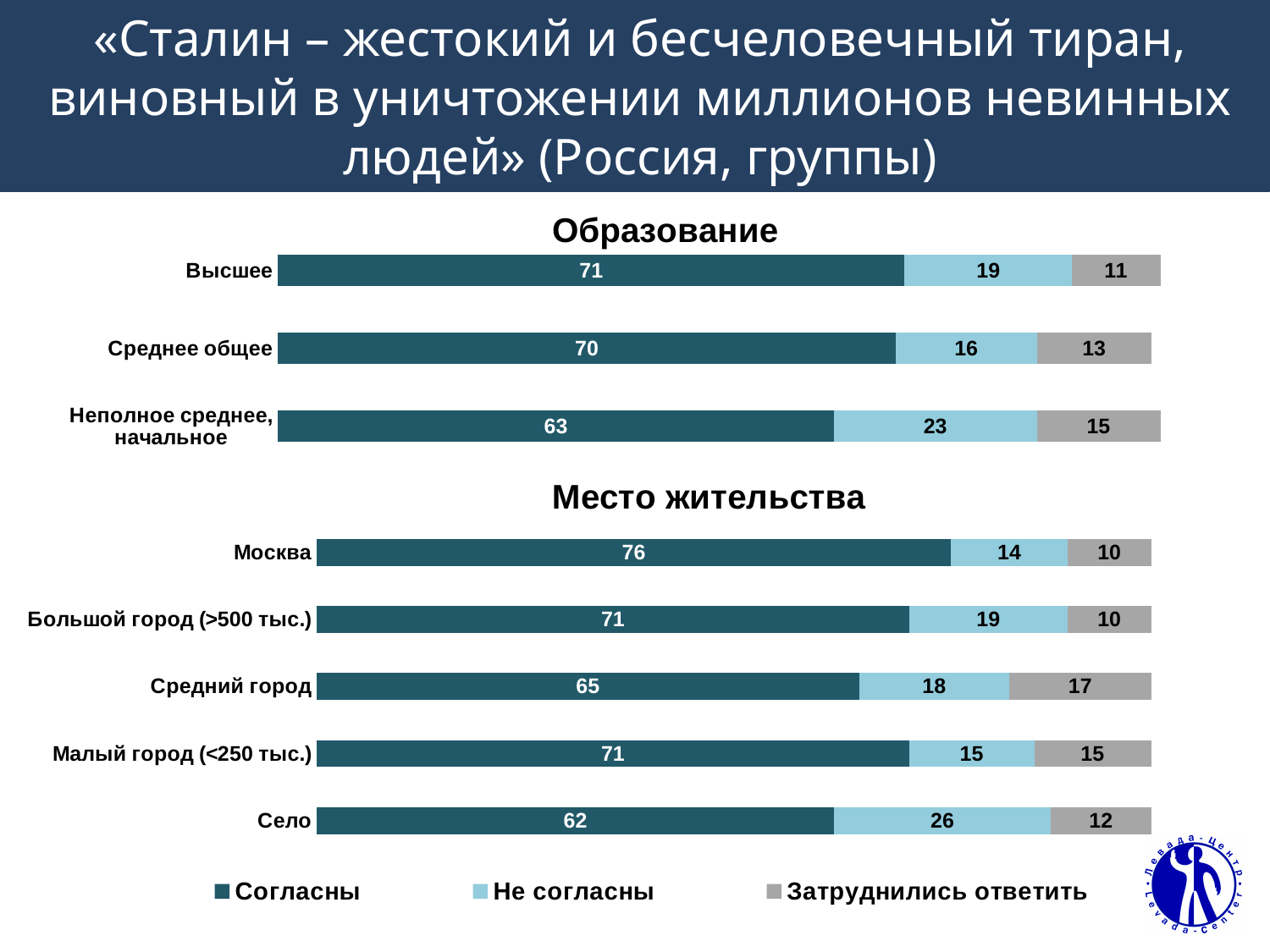
In the 'Место жительства' chart, which is larger: the 'Согласны' value for 'Средний город' or for 'Село'? Средний город In the 'Образование' chart, which category has the lowest 'Согласны' value? Неполное среднее, начальное In the 'Место жительства' chart, which category has the highest 'Затруднились ответить' value? Средний город In the 'Образование' chart, how many categories are shown? 3 How many series does the legend list? 3 In the 'Образование' chart, what is the value for 'Не согласны' for 'Неполное среднее, начальное'? 23 In the 'Образование' chart, what is the value for 'Согласны' for 'Высшее'? 71 In the 'Место жительства' chart, what is the value for 'Согласны' for 'Москва'? 76 In the 'Место жительства' chart, what is the value for 'Не согласны' for 'Село'? 26 In the 'Образование' chart, what is the difference between the 'Затруднились ответить' values for 'Неполное среднее, начальное' and 'Высшее'? 4 In the 'Место жительства' chart, which category has the highest 'Согласны' value? Москва In the 'Место жительства' chart, how many categories are shown? 5